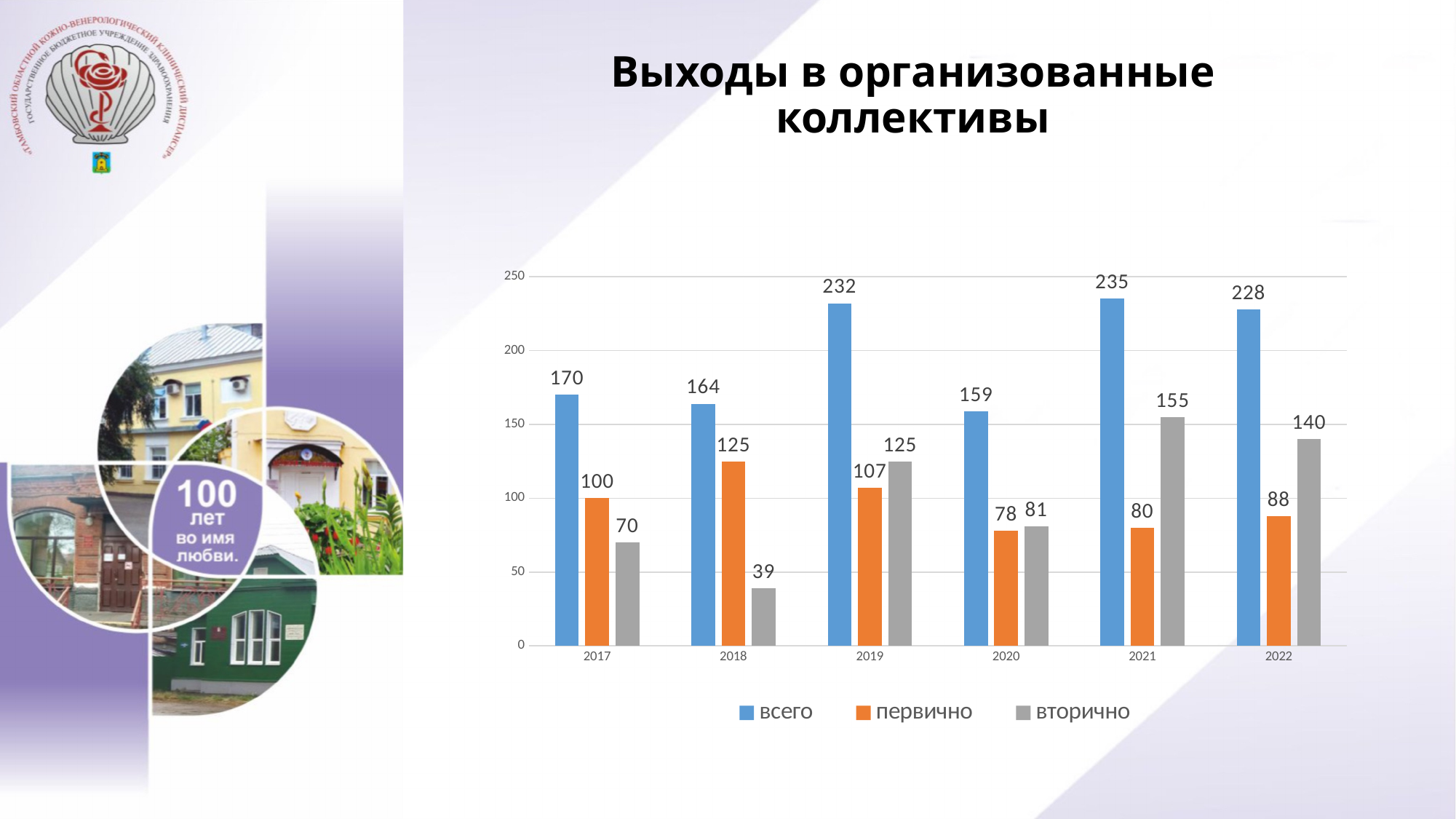
How many years are shown on the x axis? 6 What kind of chart is shown on the slide? bar chart What is the title of the chart on the slide? Выходы в организованные коллективы What is the value of the "первично" series for 2018? 125 In which year is the "всего" series highest? 2021 What is the difference between the "всего" values for 2021 and 2020? 76 What is the value of the "вторично" series for 2022? 140 In which year is the "вторично" series lowest? 2018 What is the value of the "всего" series for 2019? 232 How many series does the legend list? 3 Is the "всего" value for 2017 greater or less than 150? greater Which is larger in 2020: the "первично" value or the "вторично" value? вторично